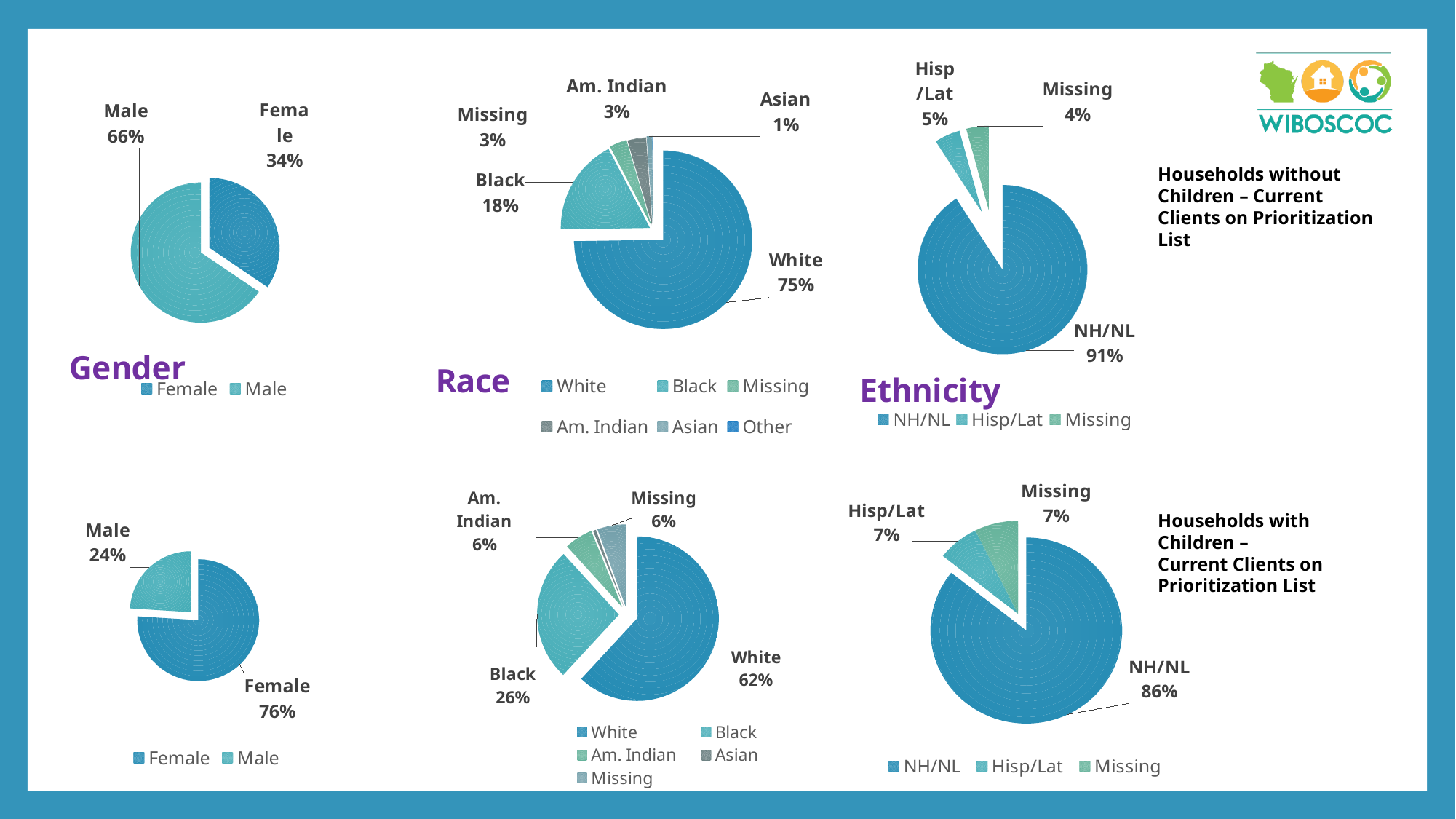
In the Gender pie chart for Households with Children (bottom left), what share is Female? 76% In the Gender pie chart for Households without Children (top left), which is larger, the Male share or the Female share? Male In the Ethnicity pie chart for Households with Children (bottom right), what is the difference between the NH/NL share and the Hisp/Lat share? 79 percentage points How many entries does the legend of the Race chart for Households without Children (top middle) list? 6 In the Gender pie chart for Households without Children (top left), what share is Male? 66% In the Ethnicity pie chart for Households without Children (top right), what share is NH/NL? 91% In the Race pie chart for Households with Children (bottom middle), what is the combined share of White and Black? 88% In the Race pie chart for Households with Children (bottom middle), which category has the largest share? White In the Race pie chart for Households without Children (top middle), what share is Black? 18% How many entries does the legend of the Ethnicity chart for Households with Children (bottom right) list? 3 In the Race pie chart for Households without Children (top middle), which category has the smallest labelled share? Asian What type of chart is used for the Gender breakdown on this slide? Pie chart